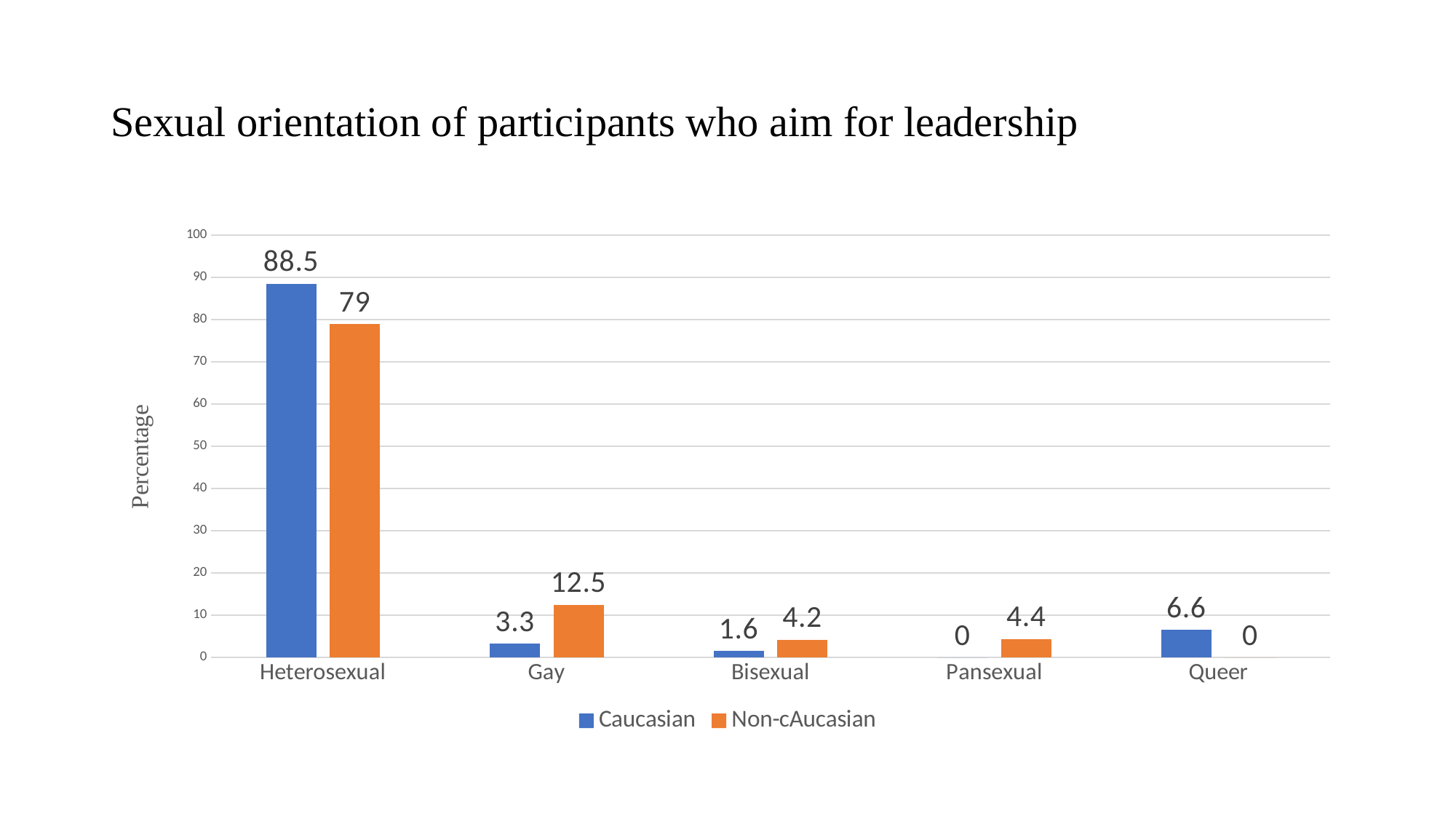
How many categories are shown on the x axis? 5 What is the title of the chart? Sexual orientation of participants who aim for leadership Which category has the highest Caucasian value? Heterosexual Which category has the lowest Caucasian value? Pansexual What is the Non-cAucasian value for Pansexual? 4.4 What is the Non-cAucasian value for Gay? 12.5 What is the Caucasian value for Heterosexual? 88.5 For Gay, which series has the larger value, Caucasian or Non-cAucasian? Non-cAucasian What is the difference between the Caucasian and Non-cAucasian values for Heterosexual? 9.5 What is the Caucasian value for Queer? 6.6 How many series does the legend list? 2 What kind of chart is shown on the slide? Bar chart